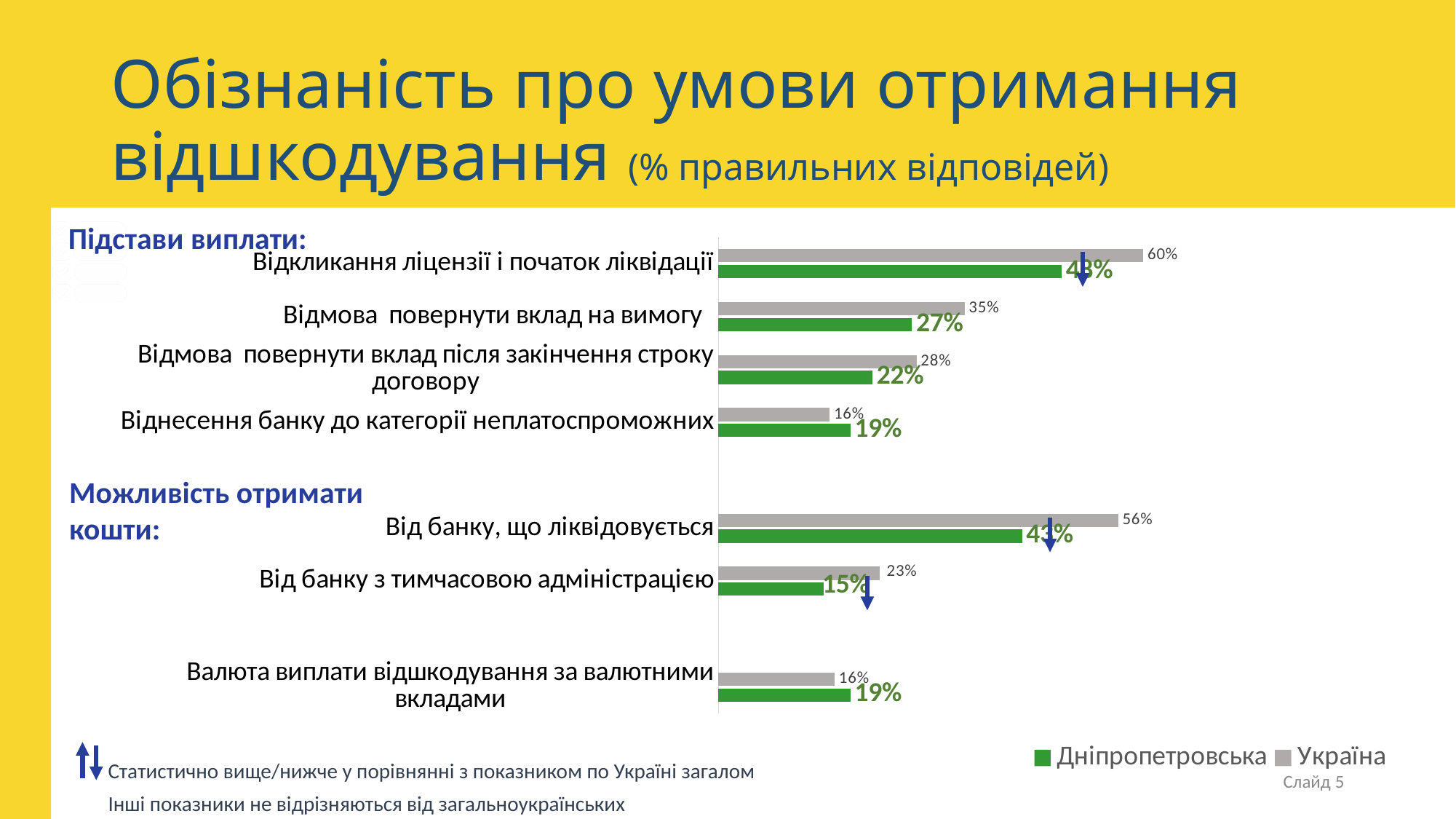
Which category has the lowest value for Дніпропетровська? Від банку з тимчасовою адміністрацією What is the difference between the Україна and Дніпропетровська values for 'Відмова повернути вклад на вимогу'? 8 percentage points For 'Віднесення банку до категорії неплатоспроможних', which is larger: the Дніпропетровська value or the Україна value? Дніпропетровська What is the value for Україна for 'Відкликання ліцензії і початок ліквідації'? 60% What is the value for Дніпропетровська for 'Відмова повернути вклад на вимогу'? 27% Which category has the highest value for Україна? Відкликання ліцензії і початок ліквідації What is the value for Дніпропетровська for 'Від банку з тимчасовою адміністрацією'? 15% How many series does the legend list? 2 What kind of chart is shown on the slide? Bar chart What is the value for Україна for 'Валюта виплати відшкодування за валютними вкладами'? 16% How many categories are plotted in the chart? 7 What is the value for Україна for 'Відмова повернути вклад після закінчення строку договору'? 28%